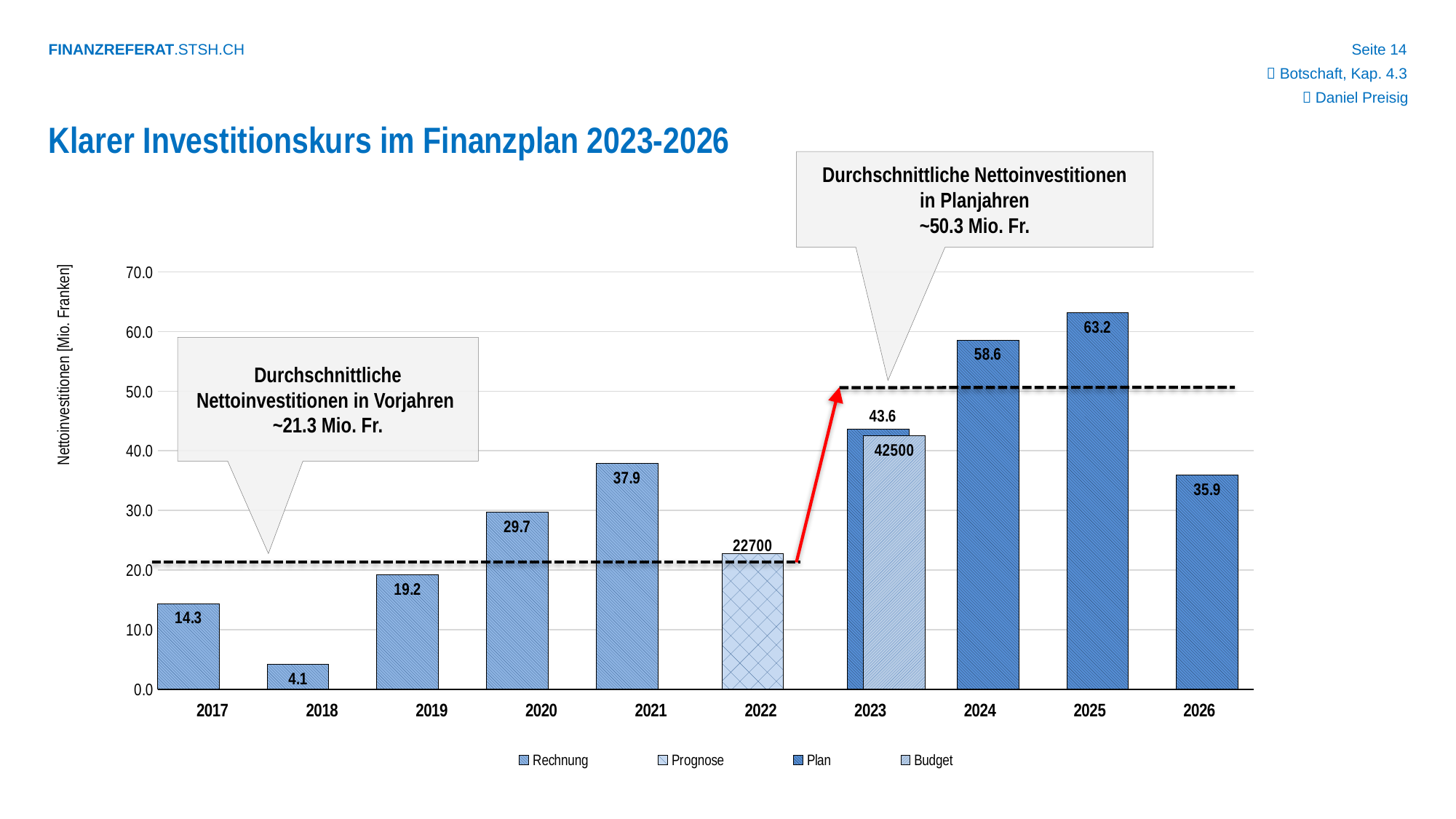
What kind of chart is shown on the slide? bar chart Do the values rise or fall from 2023 to 2025? rise How many series does the legend list? 4 What is the difference between the values for 2021 and 2020? 8.2 Which year has the highest value? 2025 What is the value for 2026? 35.9 What is the difference between the values for 2025 and 2024? 4.6 What is the Plan value for 2023? 43.6 What is the value for 2021? 37.9 Which year has the lowest value? 2018 Which is larger, the value for 2019 or the value for 2017? 2019 How many years are shown on the x axis? 10